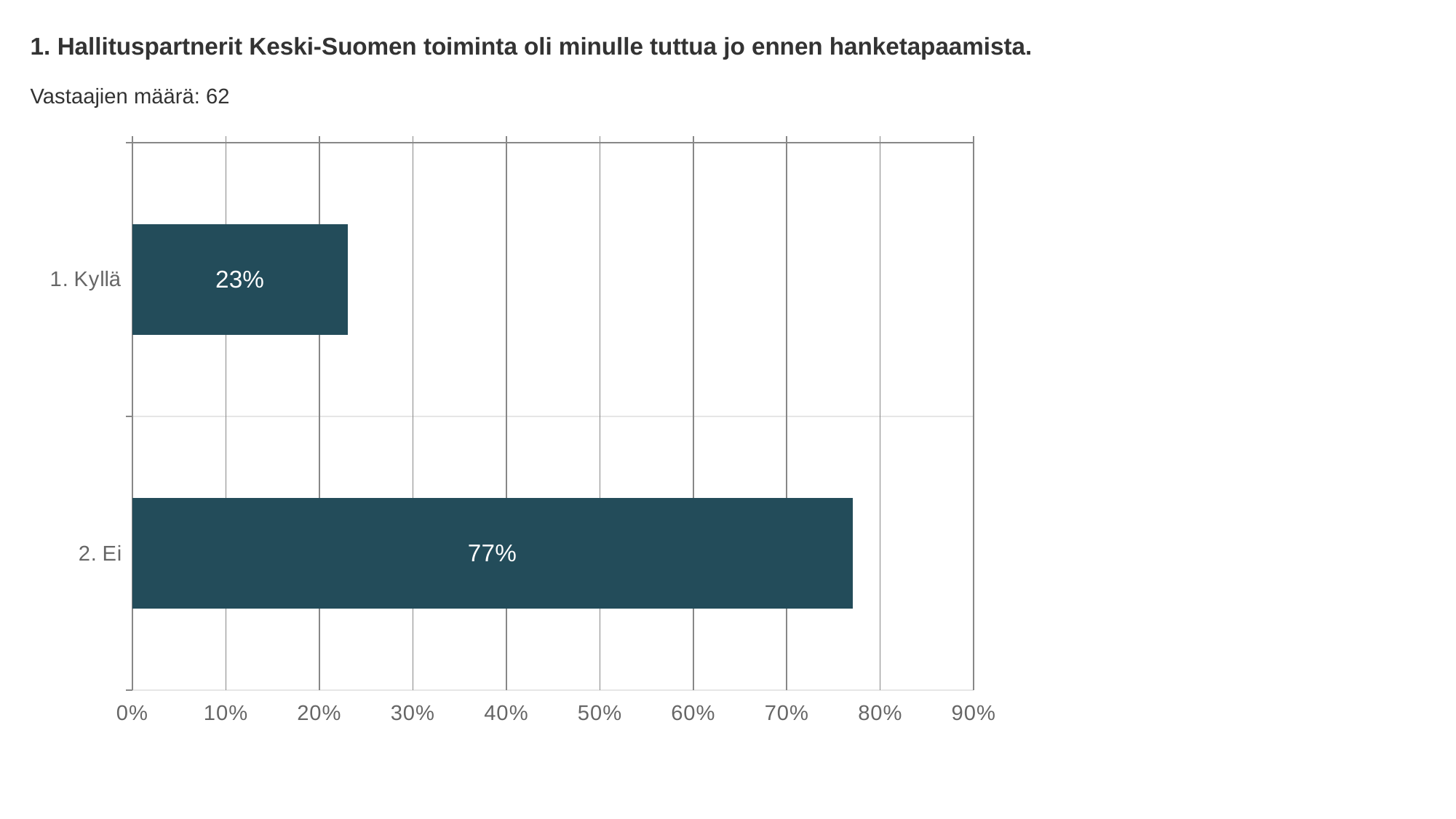
Which category has the highest value? 2. Ei What is the value for "2. Ei"? 77% What is the highest value shown on the x axis? 90% How many categories are shown in the chart? 2 Is the value for "2. Ei" greater or less than 70%? greater Which category has the lowest value? 1. Kyllä What kind of chart is shown on the slide? bar chart Is the value for "1. Kyllä" greater or less than 30%? less What is the difference between the values for "2. Ei" and "1. Kyllä"? 54% Which is larger, the value for "1. Kyllä" or the value for "2. Ei"? 2. Ei What is the number of respondents (Vastaajien määrä) stated on the slide? 62 What is the value for "1. Kyllä"? 23%